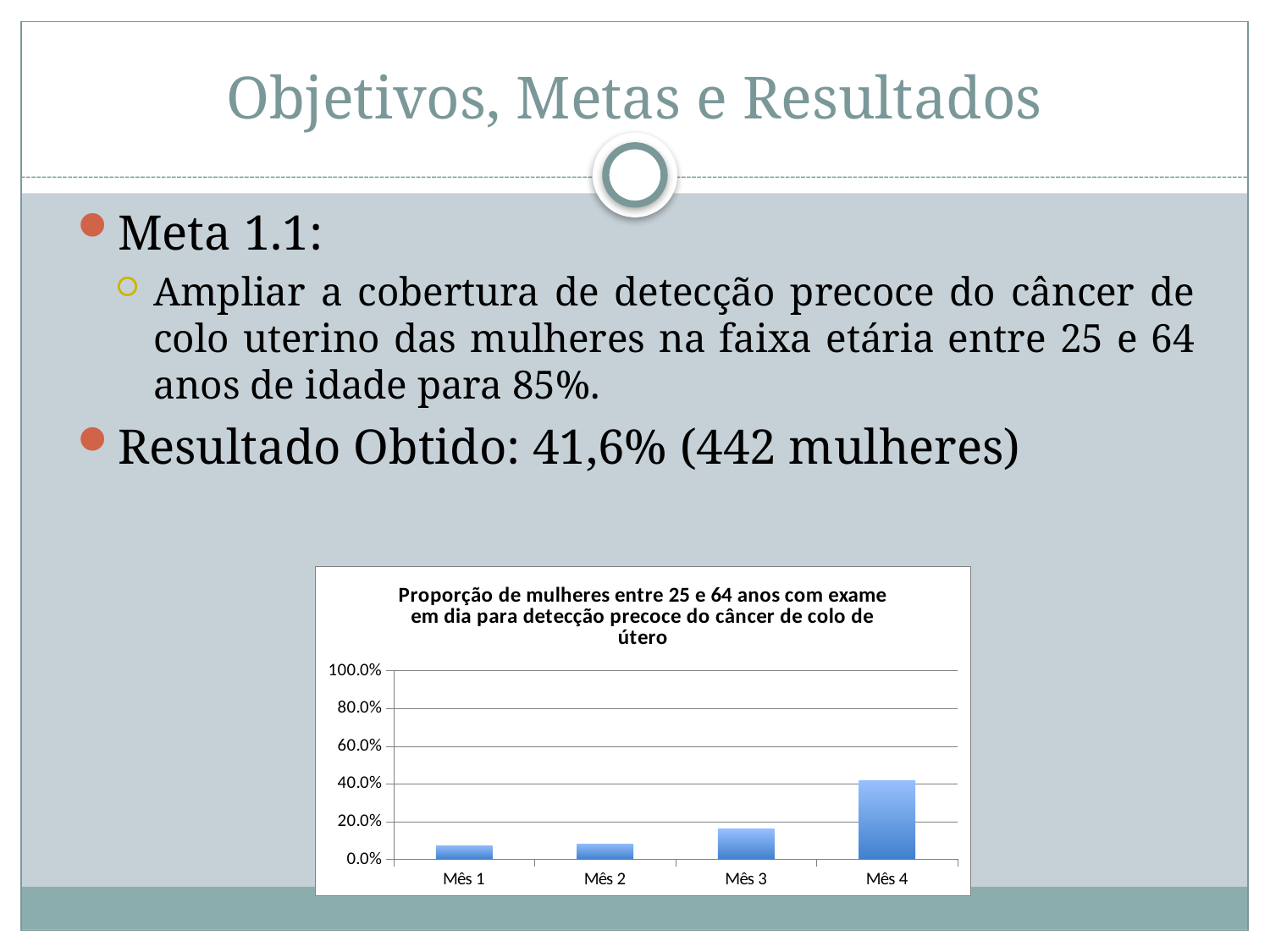
What is the title of the chart? Proporção de mulheres entre 25 e 64 anos com exame em dia para detecção precoce do câncer de colo de útero Which is larger, the value for Mês 3 or the value for Mês 4? Mês 4 Is the value for Mês 1 greater or less than 20.0%? less Is the value for Mês 3 greater or less than 20.0%? less Do the values rise or fall from Mês 1 to Mês 4? rise What kind of chart is shown on the slide? bar chart Which is larger, the value for Mês 1 or the value for Mês 3? Mês 3 How many categories (months) are plotted on the chart? 4 What is the highest value shown on the chart's vertical axis? 100.0% Which month has the highest value on the chart? Mês 4 Is the value for Mês 4 greater or less than 20.0%? greater